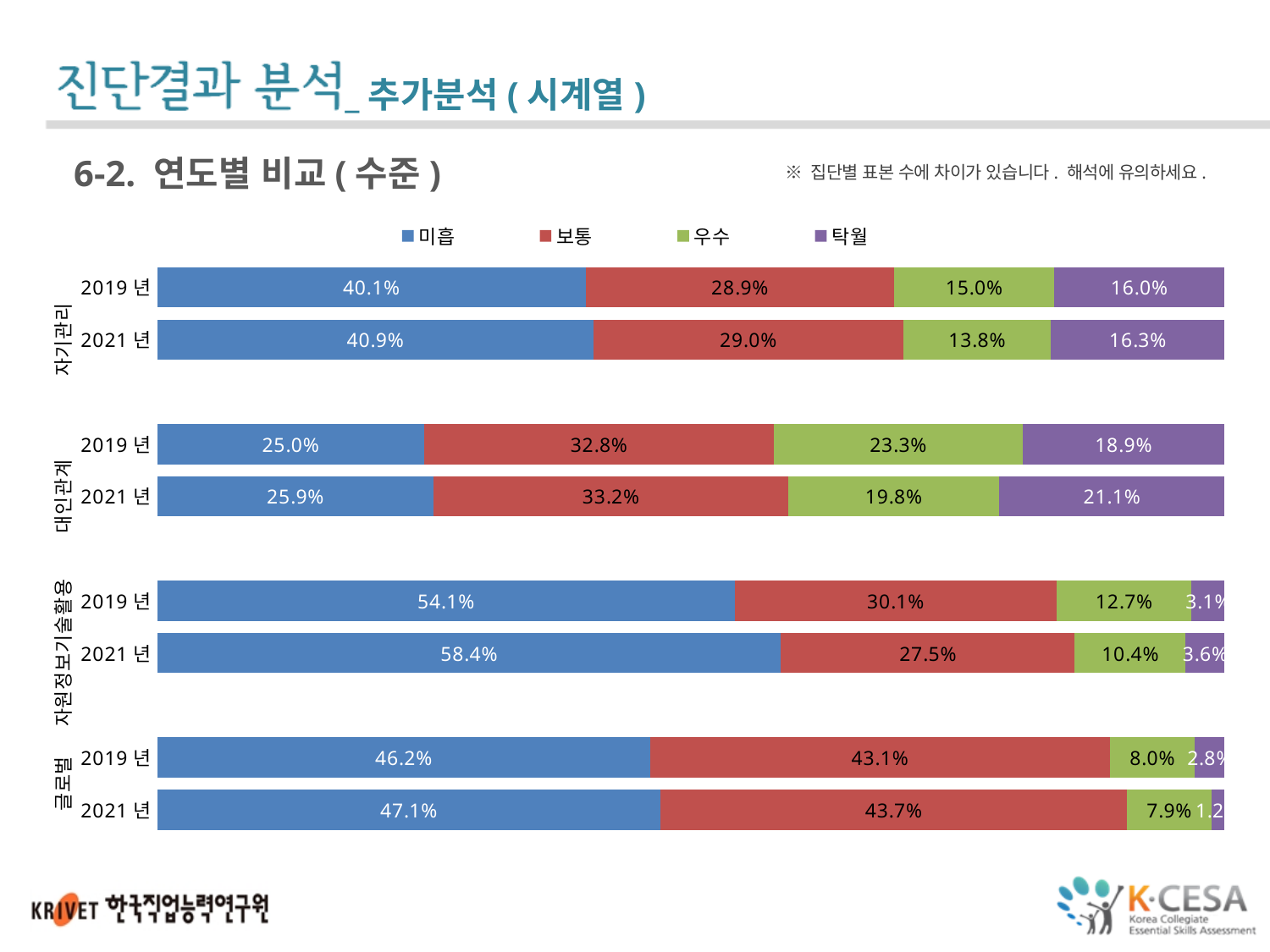
Which is larger, the 우수 value for 대인관계 in 2019년 or in 2021년? 2019년 What is the difference between the 미흡 values for 자원정보기술활용 in 2021년 and 2019년? 4.3% What is the 보통 value for 대인관계 in 2021년? 33.2% What is the 탁월 value for 대인관계 in 2019년? 18.9% What kind of chart is shown on the slide? stacked bar chart Which bar has the highest 미흡 value? 자원정보기술활용 2021년 Which bar has the lowest 미흡 value? 대인관계 2019년 How many series does the legend list? 4 Which legend entry is shown in green? 우수 What is the difference between the 보통 values for 글로벌 in 2021년 and 2019년? 0.6% What is the 미흡 value for 자기관리 in 2019년? 40.1% What is the 우수 value for 자원정보기술활용 in 2021년? 10.4%